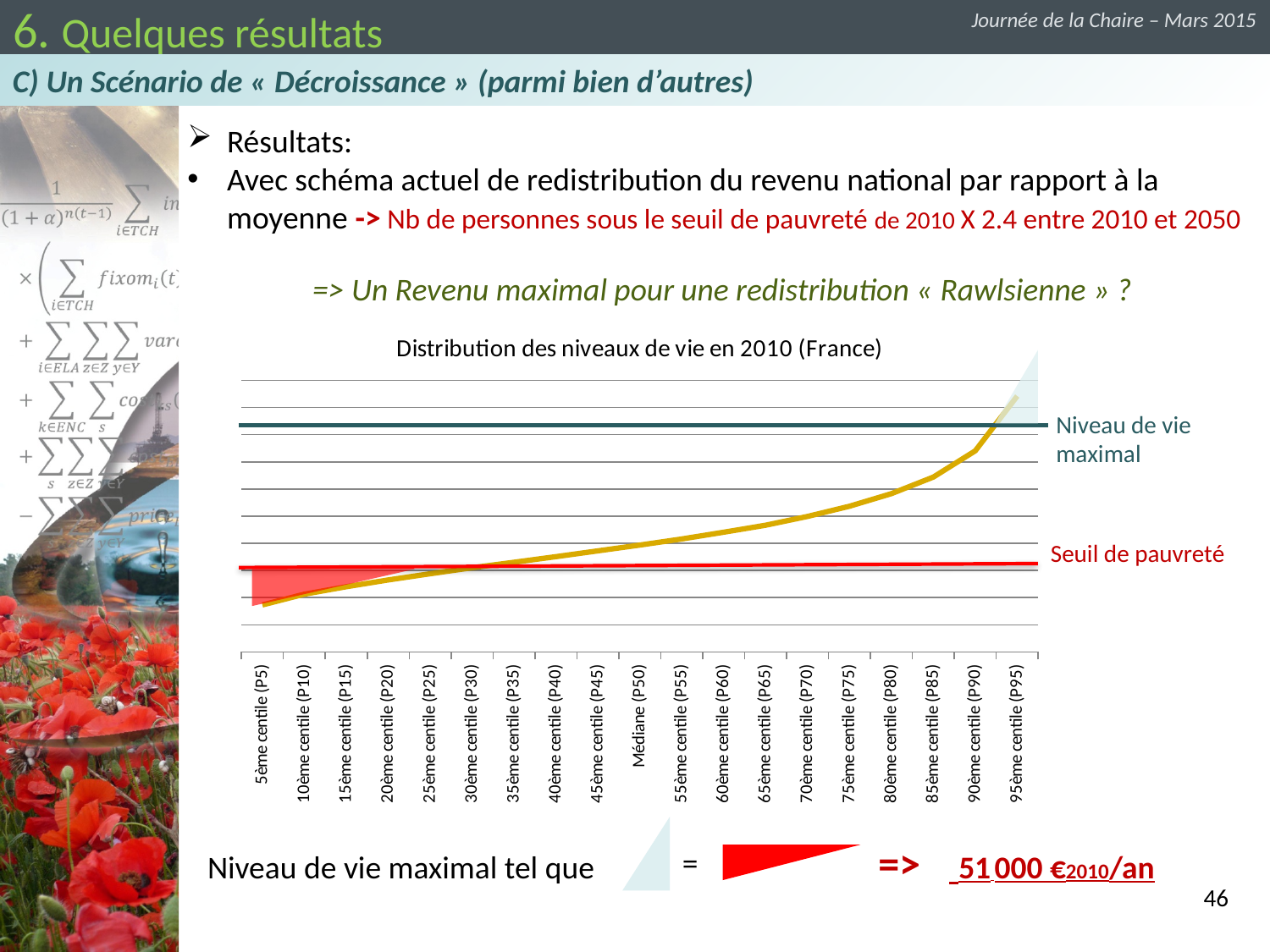
What kind of chart is shown on the slide? line chart Which is larger on the distribution curve: the value at the 90ème centile (P90) or the value at the 10ème centile (P10)? 90ème centile (P90) Which x-axis category is labelled as the median? Médiane (P50) What is the title of the chart on the slide? Distribution des niveaux de vie en 2010 (France) What is the label of the first category on the x axis of the chart? 5ème centile (P5) Which centile category has the lowest value on the distribution curve? 5ème centile (P5) Which horizontal reference line is higher on the chart: 'Niveau de vie maximal' or 'Seuil de pauvreté'? Niveau de vie maximal How many centile categories are shown on the x axis of the chart? 19 Does the plotted distribution curve rise or fall as you move from the 5ème centile (P5) to the 95ème centile (P95)? rise Which centile category has the highest value on the distribution curve? 95ème centile (P95)